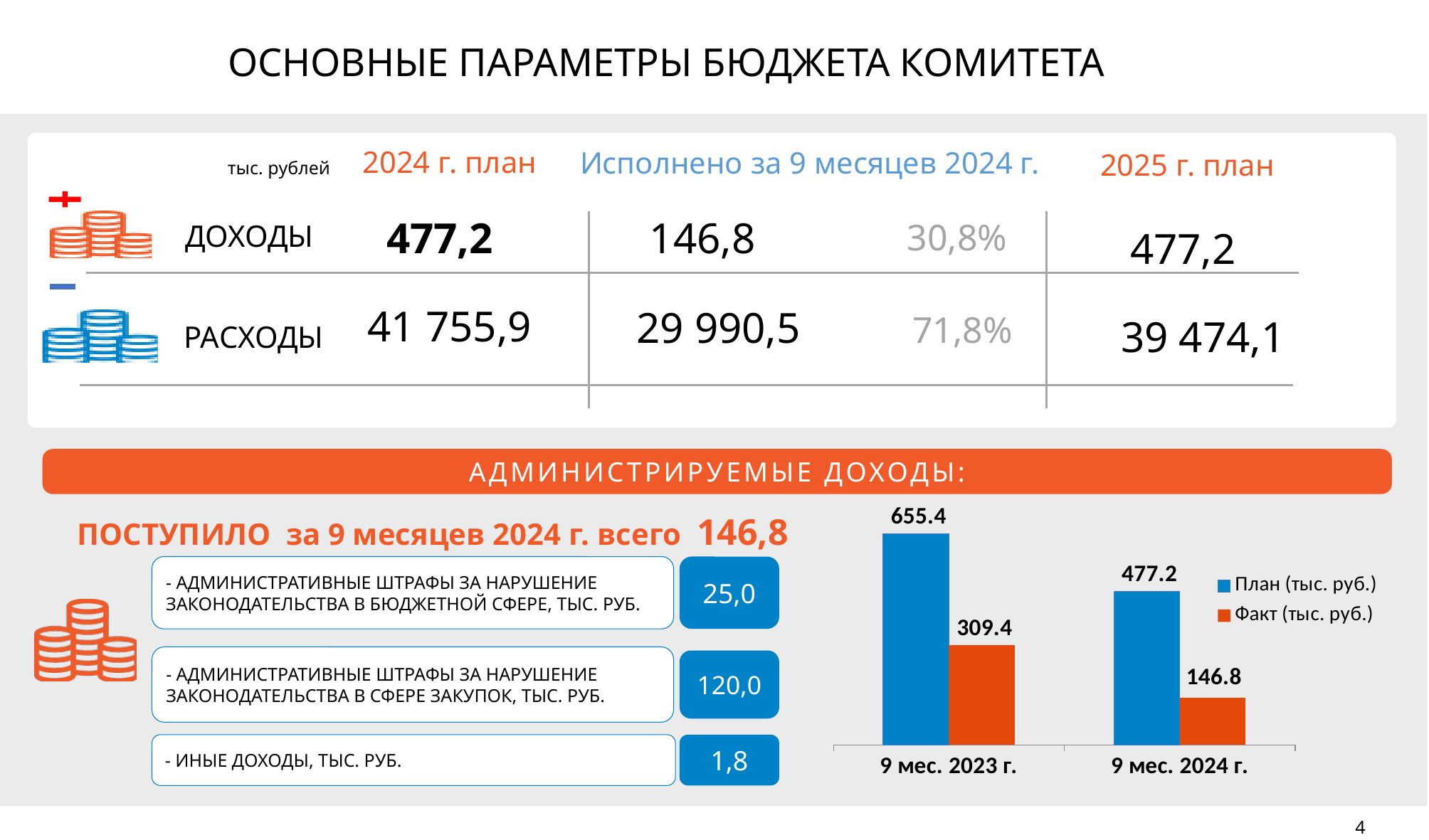
How many categories are shown on the x axis of the bar chart? 2 What type of chart is shown on the slide? bar chart Which bar in the chart has the lowest value? Факт (тыс. руб.) for 9 мес. 2024 г. In the bar chart, is Факт for 9 мес. 2023 г. larger or smaller than Факт for 9 мес. 2024 г.? larger Which bar in the chart has the highest value? План (тыс. руб.) for 9 мес. 2023 г. What is the value of План (тыс. руб.) for 9 мес. 2024 г. in the bar chart? 477.2 How many series does the legend of the bar chart list? 2 What is the value of Факт (тыс. руб.) for 9 мес. 2024 г. in the bar chart? 146.8 What is the difference between План and Факт for 9 мес. 2023 г. in the bar chart? 346.0 What is the difference between План and Факт for 9 мес. 2024 г. in the bar chart? 330.4 What is the value of План (тыс. руб.) for 9 мес. 2023 г. in the bar chart? 655.4 What is the value of Факт (тыс. руб.) for 9 мес. 2023 г. in the bar chart? 309.4